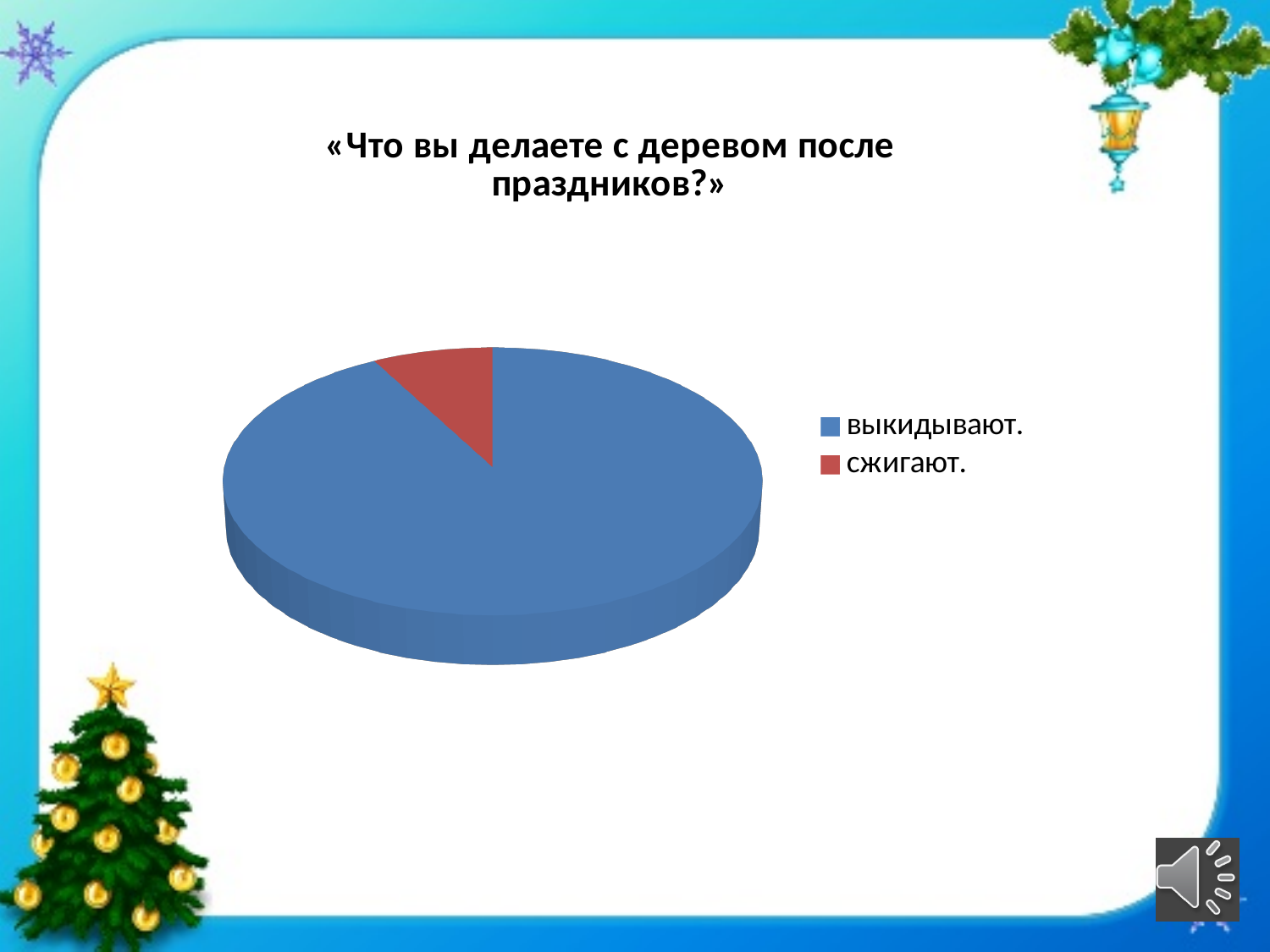
How many entries does the legend list? 2 Which category has the largest slice of the pie? выкидывают. How many slices does the pie chart have? 2 Which slice is larger, "выкидывают." or "сжигают."? выкидывают. What is the title of the chart? «Что вы делаете с деревом после праздников?» What colour is the slice for "сжигают."? red Which category has the smallest slice of the pie? сжигают. What kind of chart is shown on the slide? pie chart